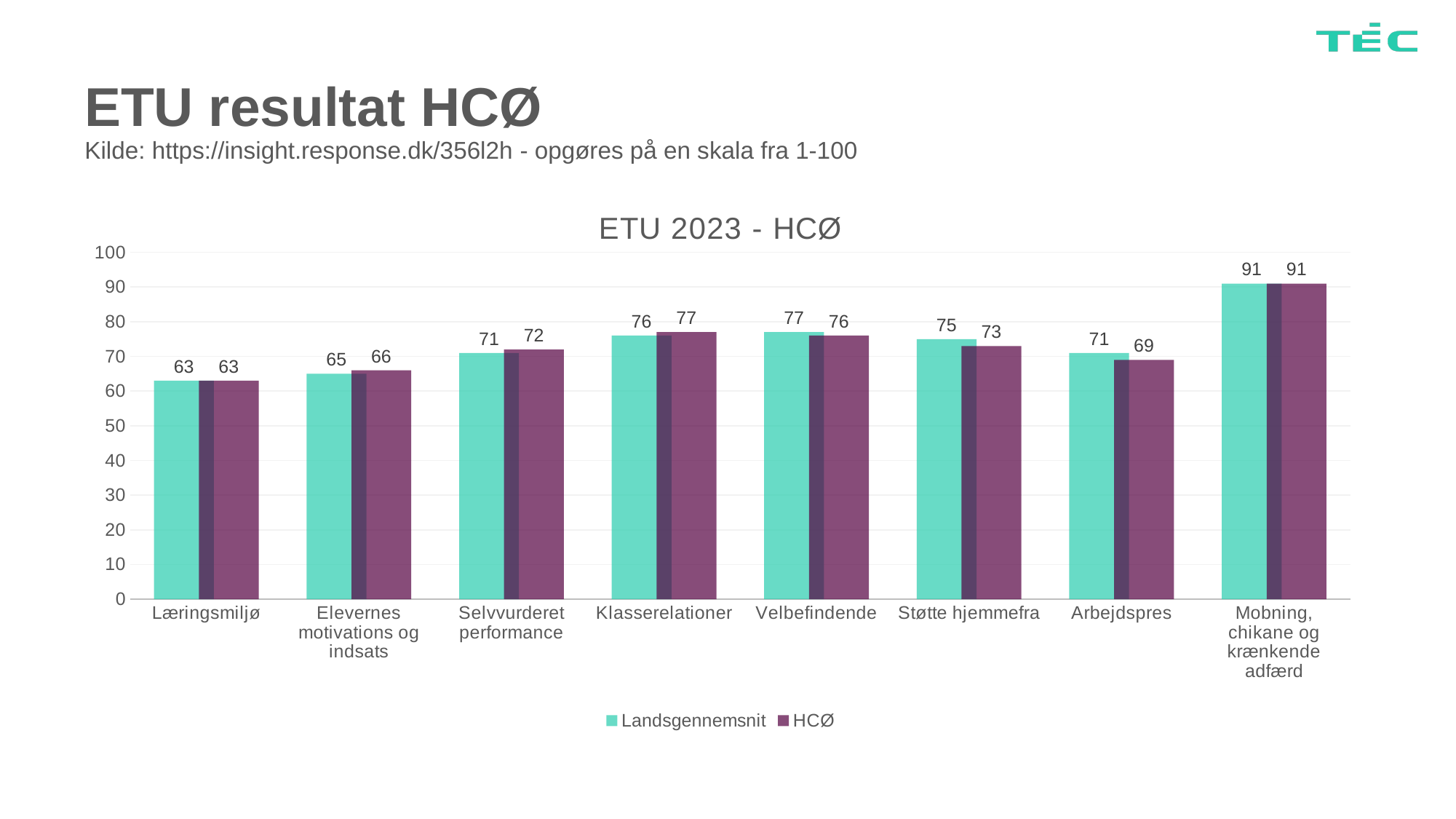
What kind of chart is shown on the slide? Bar chart Is the HCØ value for Elevernes motivations og indsats greater or less than 70? less For Klasserelationer, which series has the larger value, Landsgennemsnit or HCØ? HCØ How many categories are shown on the x axis? 8 What is the title of the chart? ETU 2023 - HCØ Which category has the highest HCØ value? Mobning, chikane og krænkende adfærd What is the HCØ value for Arbejdspres? 69 How many series does the legend list? 2 What is the difference between the Landsgennemsnit and HCØ values for Støtte hjemmefra? 2 Which category has the lowest Landsgennemsnit value? Læringsmiljø What is the Landsgennemsnit value for Velbefindende? 77 What is the HCØ value for Selvvurderet performance? 72